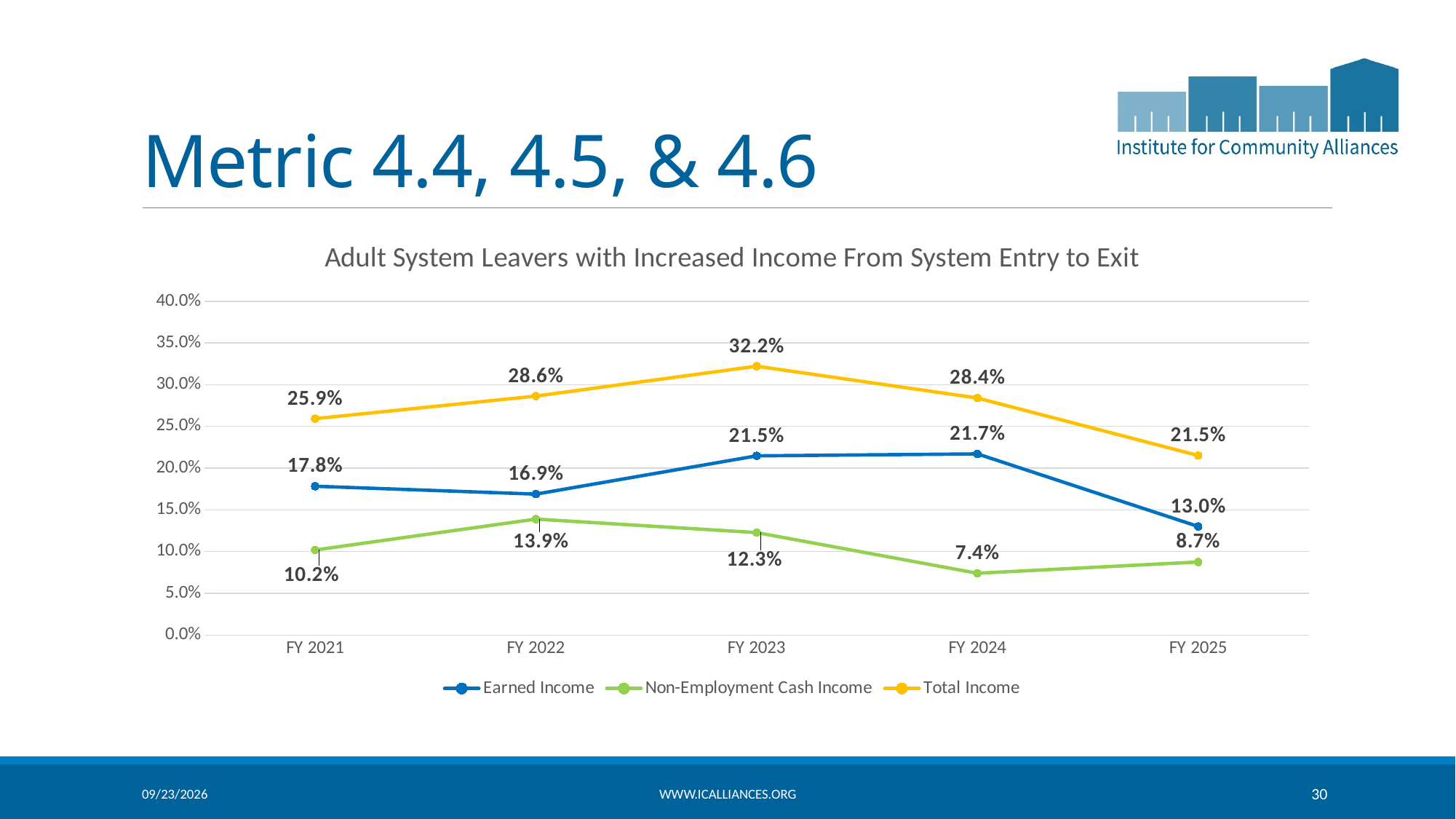
What kind of chart is shown on the slide? Line chart How many series does the legend list? 3 What is the Earned Income value for FY 2022? 16.9% In which fiscal year is Non-Employment Cash Income lowest? FY 2024 What is the difference between Total Income and Earned Income in FY 2025? 8.5% Is the Earned Income value for FY 2024 greater or less than 20.0%? greater What is the Non-Employment Cash Income value for FY 2024? 7.4% How many fiscal years are shown on the x axis? 5 What is the Total Income value for FY 2023? 32.2% Does Earned Income rise or fall from FY 2024 to FY 2025? Fall Which is larger in FY 2021: Earned Income or Non-Employment Cash Income? Earned Income In which fiscal year is Total Income highest? FY 2023